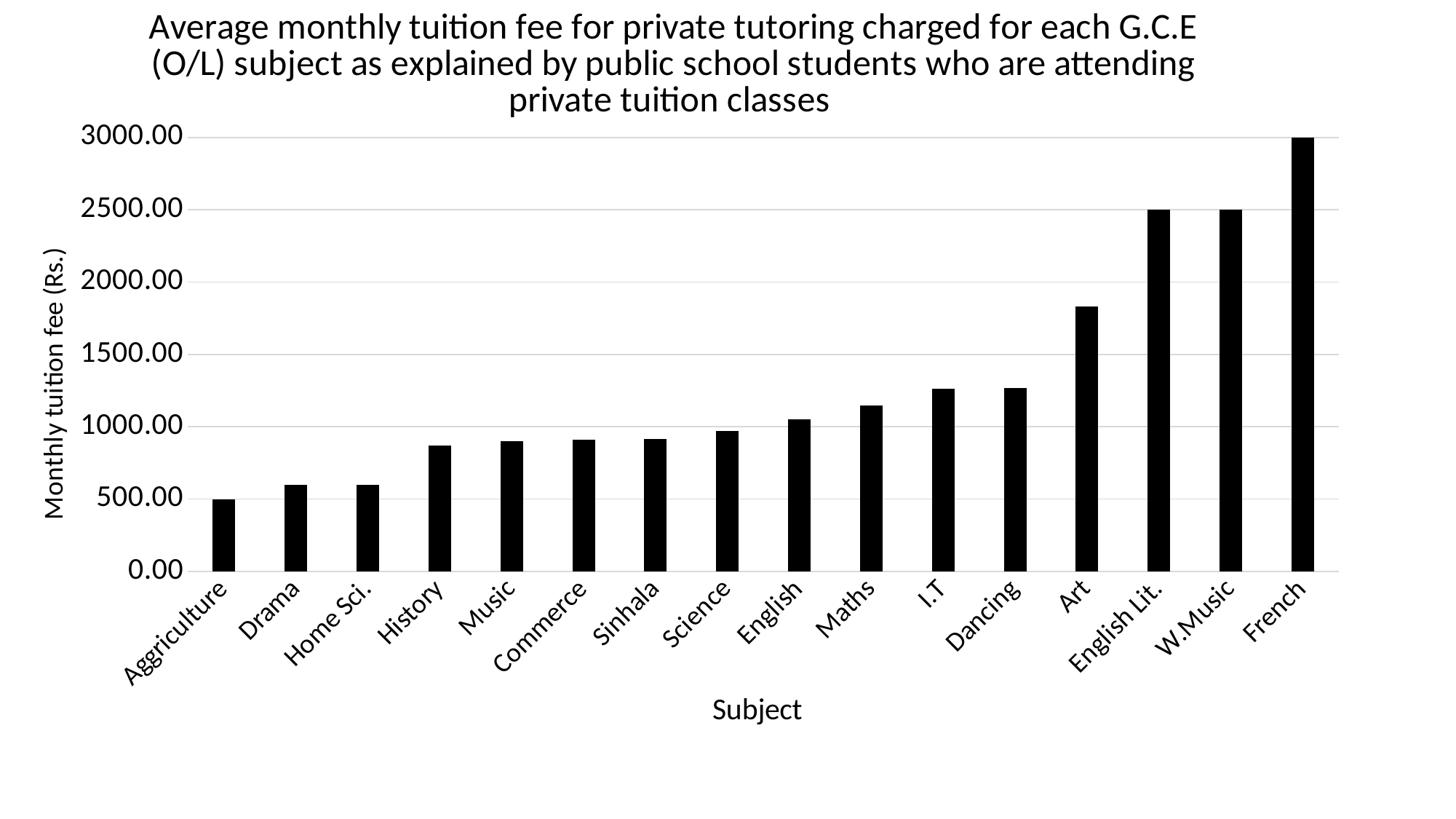
Which subject has the lowest average monthly tuition fee? Aggriculture Do the values generally rise or fall from left to right along the x axis? Rise What is the average monthly tuition fee for English Lit.? 2500.00 What is the average monthly tuition fee for French? 3000.00 Which has the larger average monthly tuition fee, Art or Maths? Art What kind of chart is shown on the slide? Bar chart Is the value for History greater or less than 1000? less Is the value for Art greater or less than 1500? greater How many subjects are shown on the x axis? 16 Which subject has the highest average monthly tuition fee? French Is the value for Maths greater or less than 1000? greater What is the label of the y axis? Monthly tuition fee (Rs.)